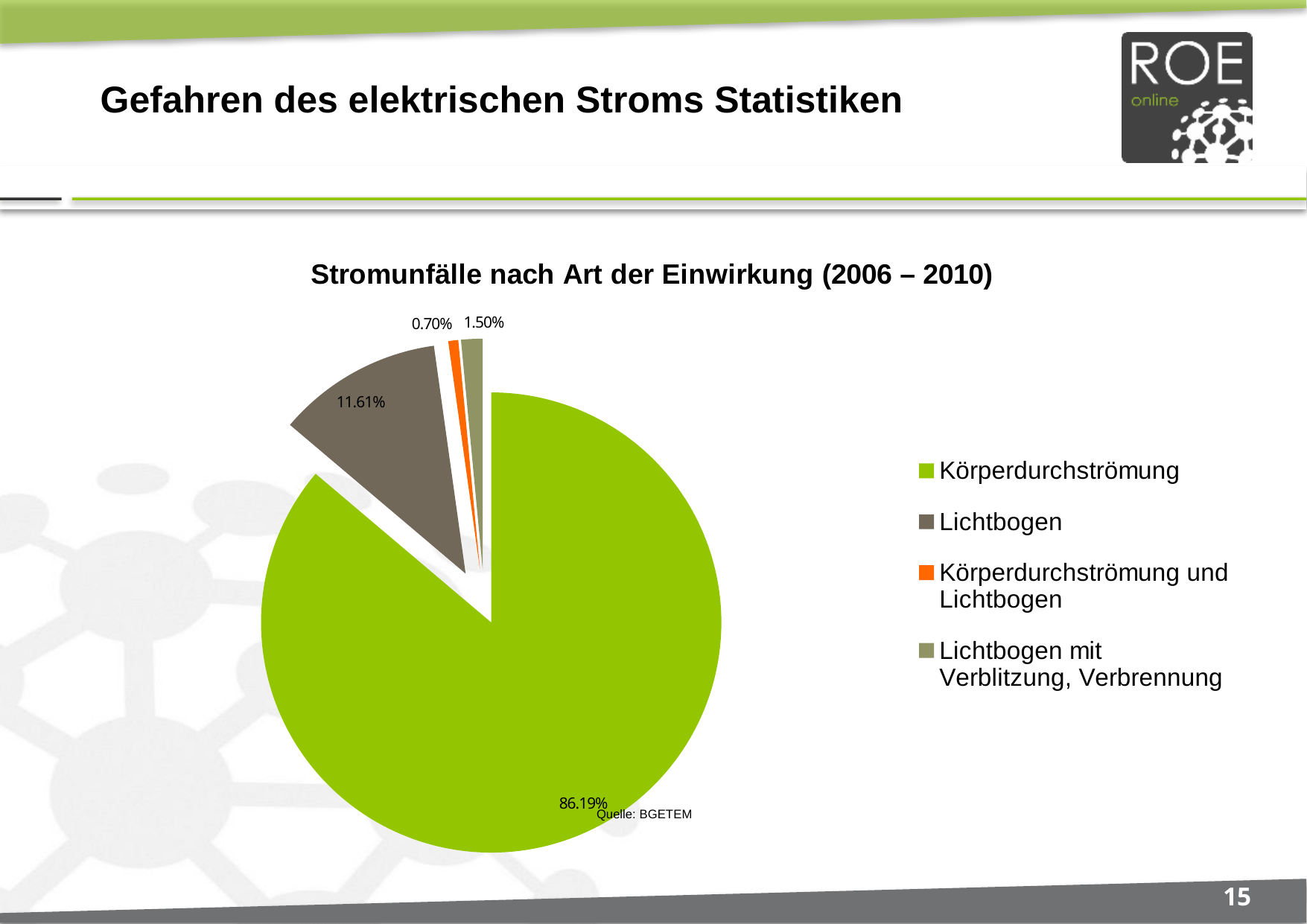
How many categories does the legend list? 4 Which category has the largest share of the pie? Körperdurchströmung What colour is the Lichtbogen slice in the pie chart? Dark grey What is the title of the chart? Stromunfälle nach Art der Einwirkung (2006 – 2010) What percentage of the pie is Lichtbogen mit Verblitzung, Verbrennung? 1.50% What is the difference in percentage points between Körperdurchströmung and Lichtbogen? 74.58 What percentage of the pie is Lichtbogen? 11.61% Which category has the smallest share of the pie? Körperdurchströmung und Lichtbogen What percentage of the pie is Körperdurchströmung? 86.19% What type of chart is shown on the slide? Pie chart Which is larger: the share for Lichtbogen mit Verblitzung, Verbrennung or the share for Körperdurchströmung und Lichtbogen? Lichtbogen mit Verblitzung, Verbrennung What percentage of the pie is Körperdurchströmung und Lichtbogen? 0.70%